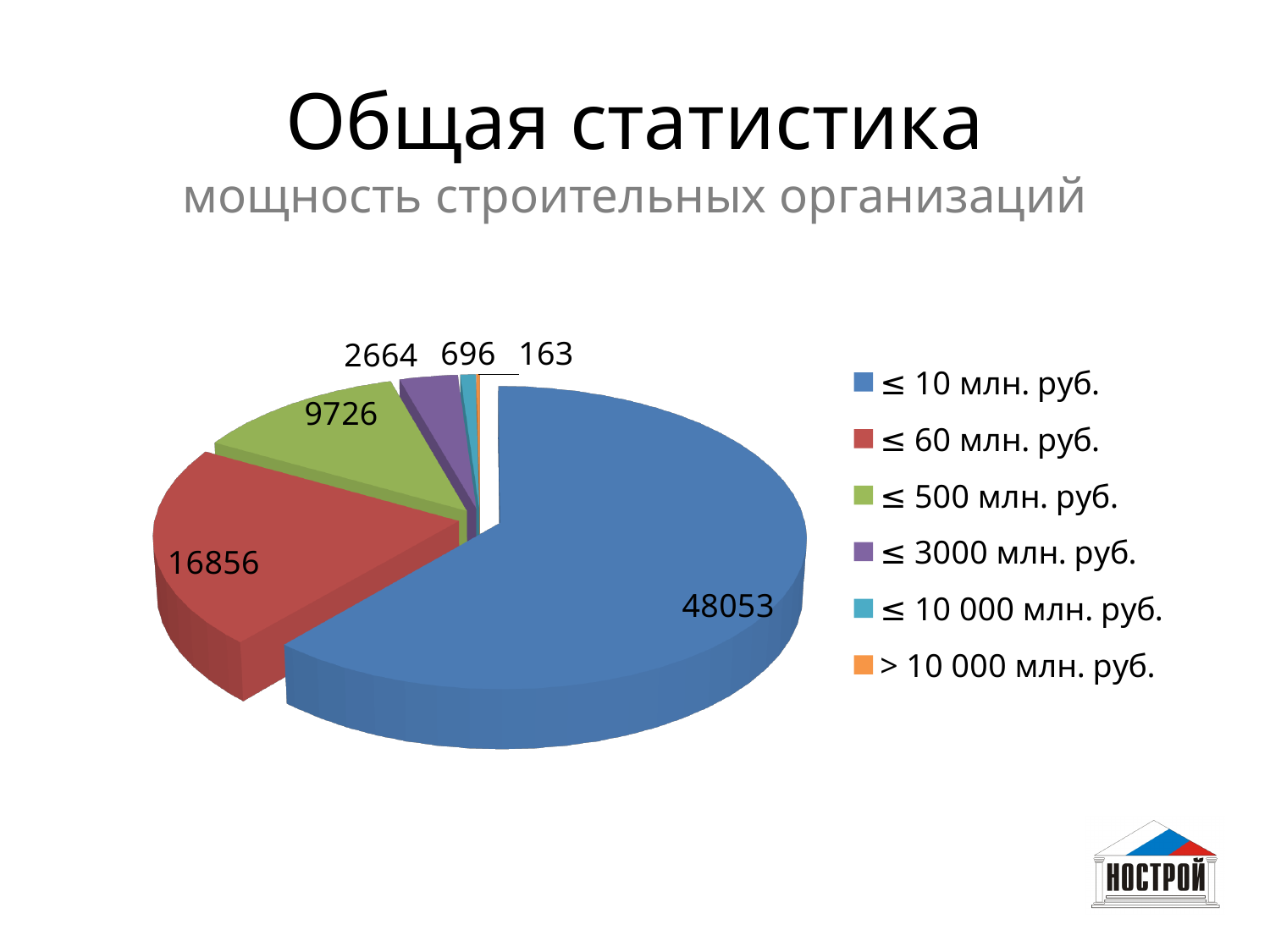
How many categories does the legend list? 6 What is the value for the > 10 000 млн. руб. slice? 163 What is the value for the ≤ 500 млн. руб. slice? 9726 What is the difference between the ≤ 10 млн. руб. and ≤ 60 млн. руб. values? 31197 Which is larger, the ≤ 500 млн. руб. slice or the ≤ 3000 млн. руб. slice? ≤ 500 млн. руб. What type of chart is shown on the slide? pie chart What is the subtitle of the slide below the main title? мощность строительных организаций Which category has the largest slice? ≤ 10 млн. руб. What is the value for the ≤ 60 млн. руб. slice? 16856 What is the difference between the ≤ 3000 млн. руб. and ≤ 10 000 млн. руб. values? 1968 What is the value for the ≤ 10 млн. руб. slice? 48053 Which category has the smallest slice? > 10 000 млн. руб.